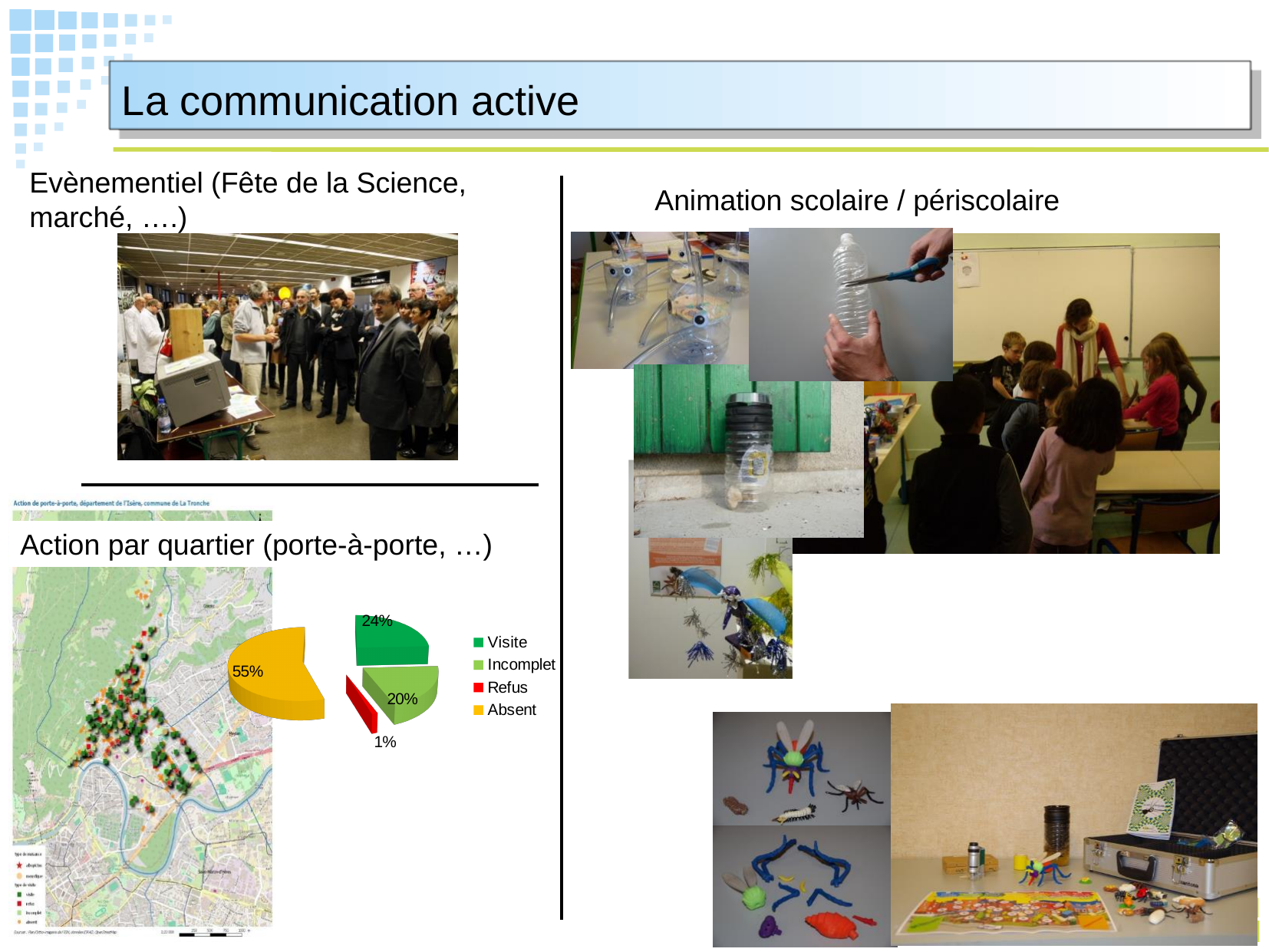
Which category has the largest slice in the pie chart? Absent Which category has the smallest slice in the pie chart? Refus What share of the pie chart is Refus? 1% What share of the pie chart is Incomplet? 20% Which is larger in the pie chart, Visite or Incomplet? Visite What kind of chart is shown on the slide? pie chart What share of the pie chart is Absent? 55% How many categories does the pie chart legend list? 4 What colour is the Absent slice in the pie chart? yellow What is the difference in percentage points between Absent and Visite in the pie chart? 31 What colour is the Refus slice in the pie chart? red What share of the pie chart is Visite? 24%